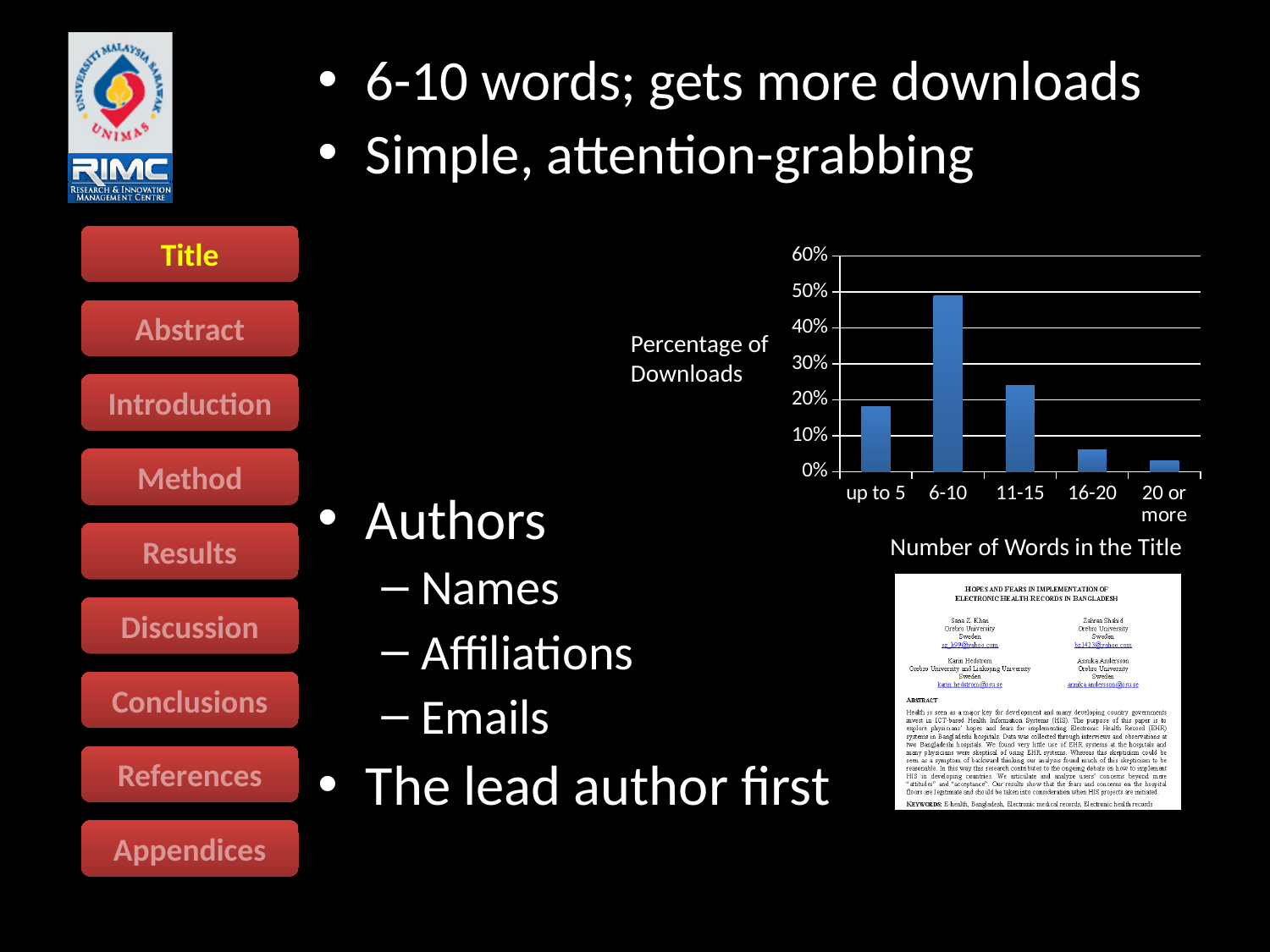
Is the percentage of downloads for 6-10 words greater or less than 40%? greater Is the percentage of downloads for 16-20 words greater or less than 10%? less Is the percentage of downloads for 11-15 words greater or less than 20%? greater What is the label on the x axis of the chart? Number of Words in the Title How many categories are shown on the x axis of the chart? 5 What kind of chart is shown on the slide? bar chart Which number-of-words category has the lowest percentage of downloads? 20 or more Which has a higher percentage of downloads: 'up to 5' words or 11-15 words? 11-15 Do the percentages rise or fall from the 6-10 category to the '20 or more' category? fall Which number-of-words category has the highest percentage of downloads? 6-10 Which has a higher percentage of downloads: 16-20 words or 20 or more words? 16-20